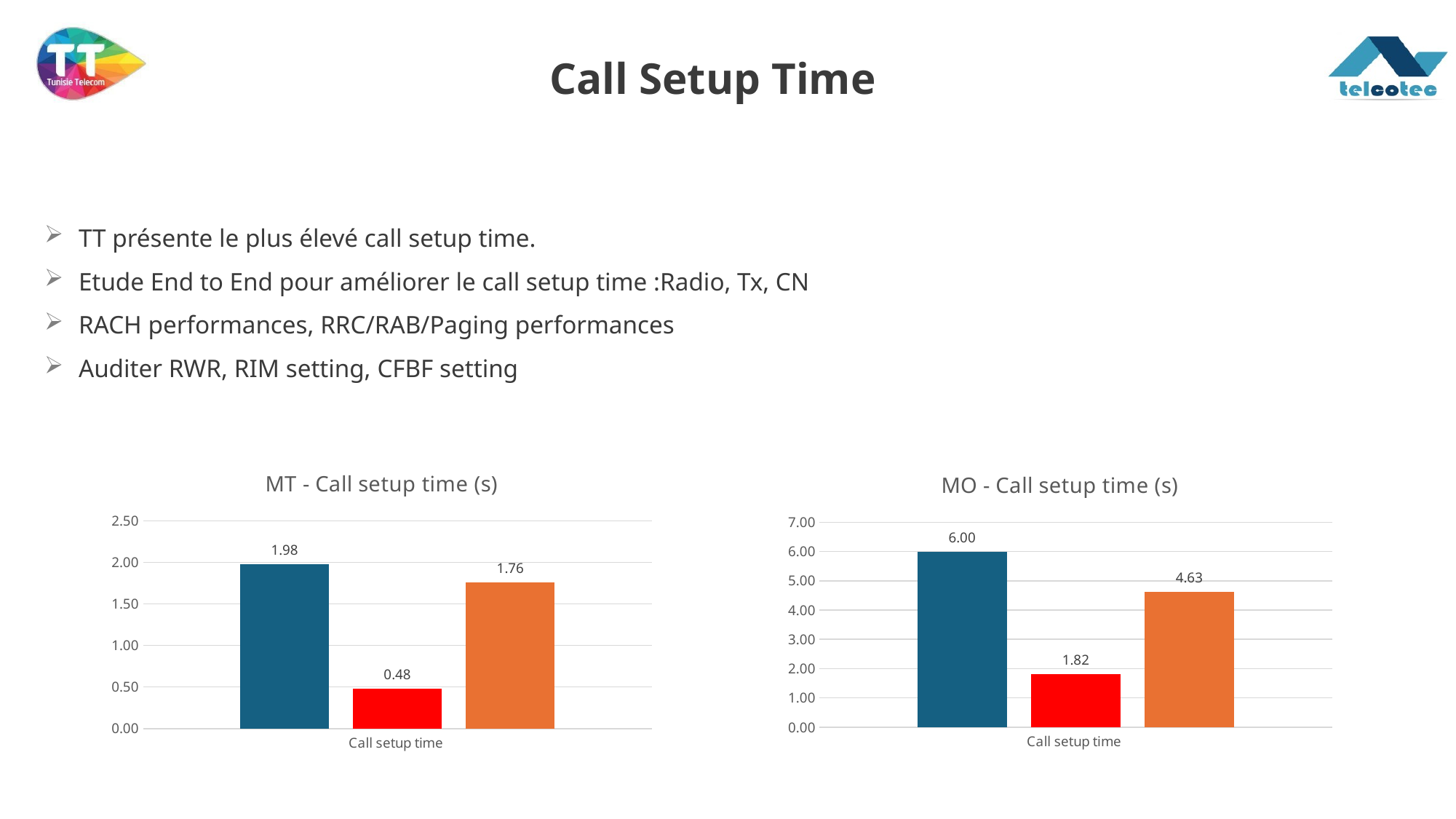
How many bars are plotted in the "MT - Call setup time (s)" chart? 3 In the "MO - Call setup time (s)" chart, what is the value of the blue bar? 6.00 In the "MO - Call setup time (s)" chart, which bar has the highest value? the blue bar (6.00) In the "MO - Call setup time (s)" chart, what is the value of the orange bar? 4.63 In the "MO - Call setup time (s)" chart, which is larger, the red bar or the orange bar? the orange bar In the "MT - Call setup time (s)" chart, what is the value of the blue bar? 1.98 What is the x-axis category label shown under the bars in the "MT - Call setup time (s)" chart? Call setup time What type of chart is the "MO - Call setup time (s)" chart? bar chart In the "MO - Call setup time (s)" chart, what is the difference between the blue bar and the red bar? 4.18 In the "MT - Call setup time (s)" chart, what is the value of the red bar? 0.48 In the "MT - Call setup time (s)" chart, what is the difference between the blue bar and the orange bar? 0.22 In the "MT - Call setup time (s)" chart, which bar has the lowest value? the red bar (0.48)